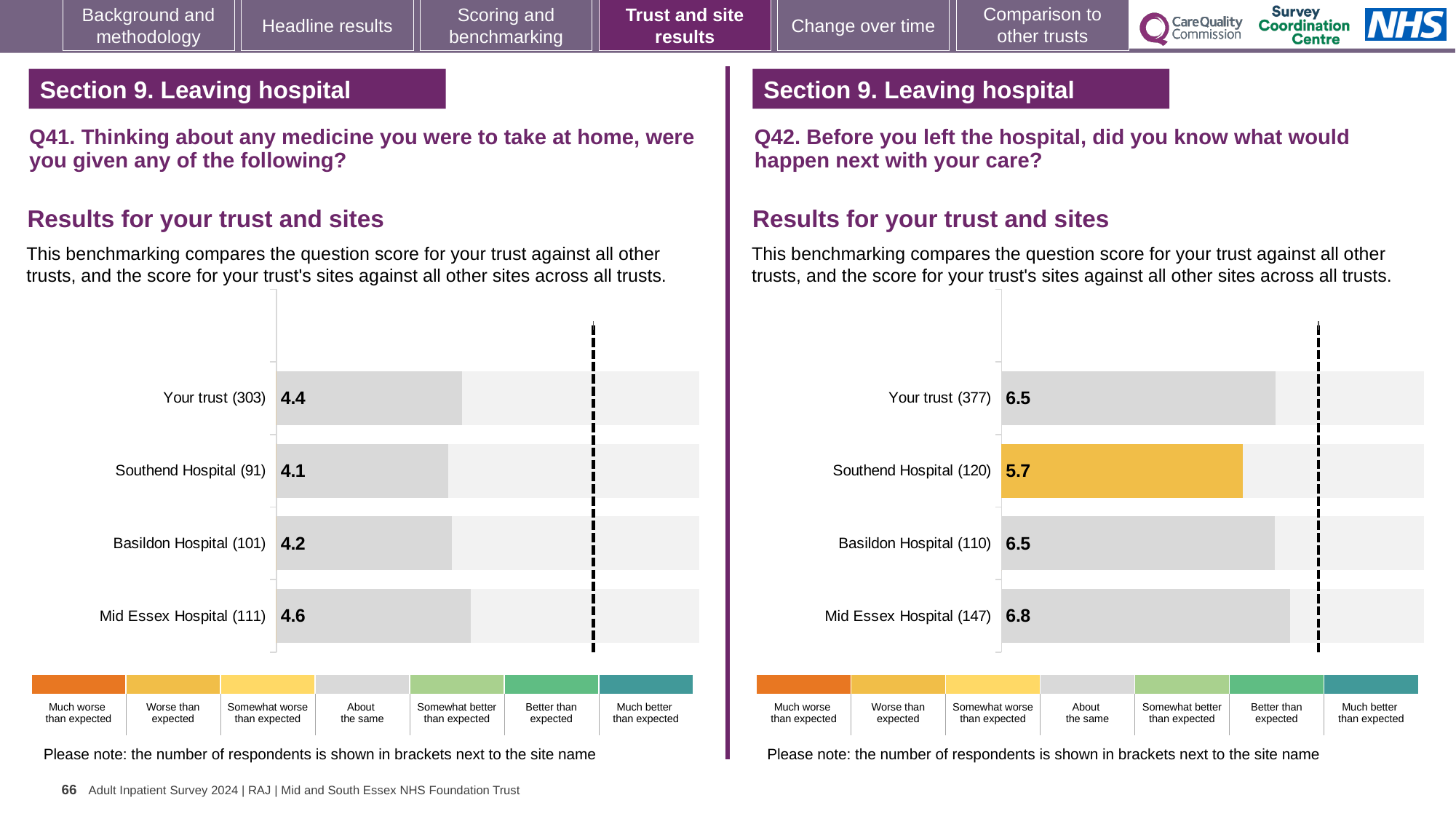
On the Q42 chart (right), what is the score for Mid Essex Hospital? 6.8 On the Q42 chart (right), how many respondents are shown in brackets for Your trust? 377 On the Q41 chart (left), how many bars are plotted? 4 What type of chart is used on the Q42 chart (right)? Bar chart On the Q41 chart (left), what is the difference between the scores for Mid Essex Hospital and Southend Hospital? 0.5 On the Q42 chart (right), what is the score for Southend Hospital? 5.7 On the Q42 chart (right), which is larger: the score for Basildon Hospital or Southend Hospital? Basildon Hospital On the Q41 chart (left), which site has the lowest score? Southend Hospital On the Q42 chart (right), which site has the highest score? Mid Essex Hospital On the Q42 chart (right), what is the difference between the scores for Your trust and Southend Hospital? 0.8 On the Q41 chart (left), what is the score for Mid Essex Hospital? 4.6 On the Q41 chart (left), what is the score for Your trust? 4.4